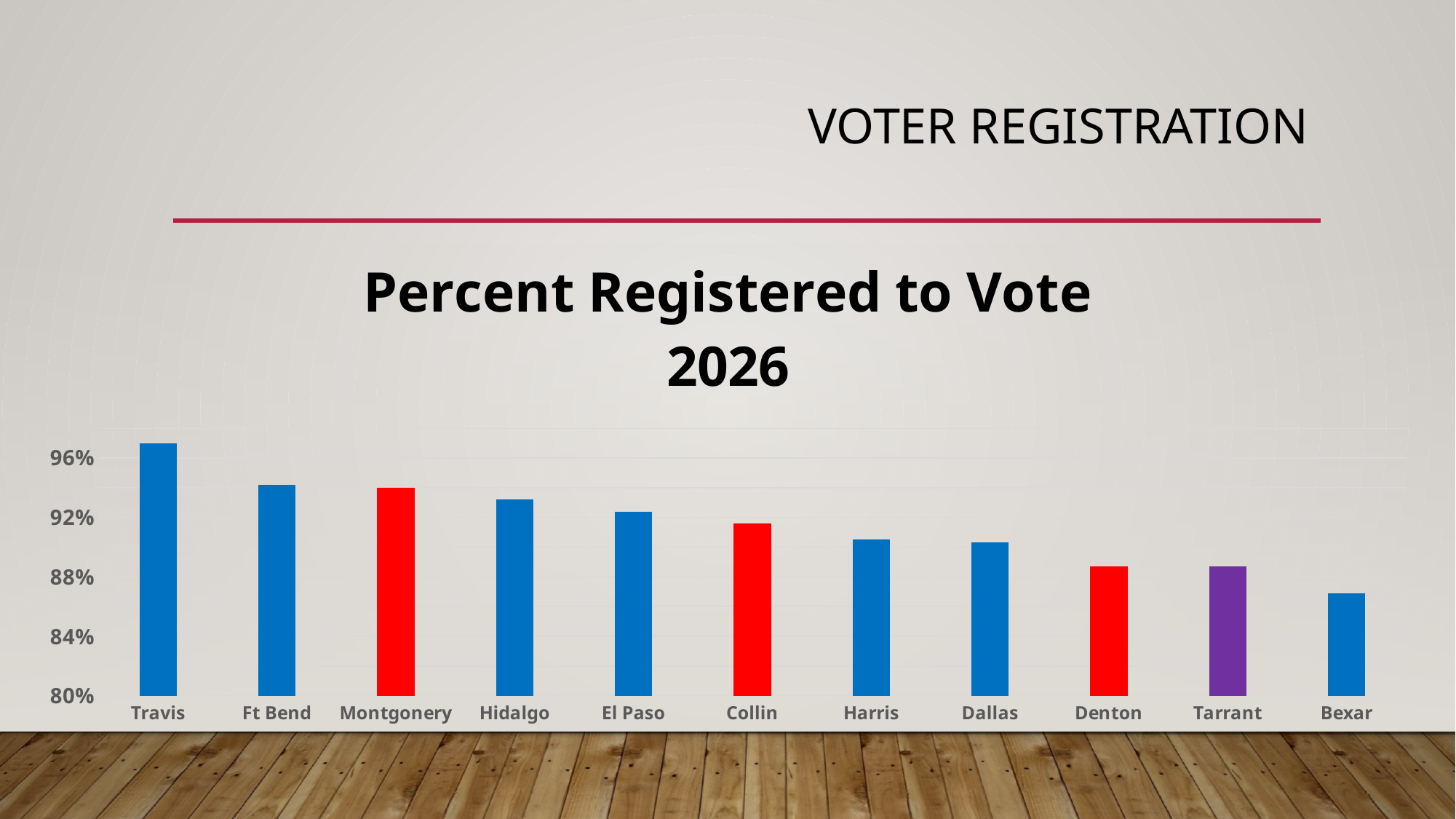
Is the value for Travis greater or less than 96%? greater Is the value for Harris greater or less than 92%? less What colour is the bar for Tarrant? purple What is the title of the chart? Percent Registered to Vote 2026 Is the value for Bexar greater or less than 88%? less Which county has the highest percent registered to vote? Travis Which has a higher percent registered to vote, Hidalgo or Harris? Hidalgo Which county has the lowest percent registered to vote? Bexar What kind of chart is shown on the slide? bar chart Do the values rise or fall from left to right across the chart? fall How many counties are shown on the chart? 11